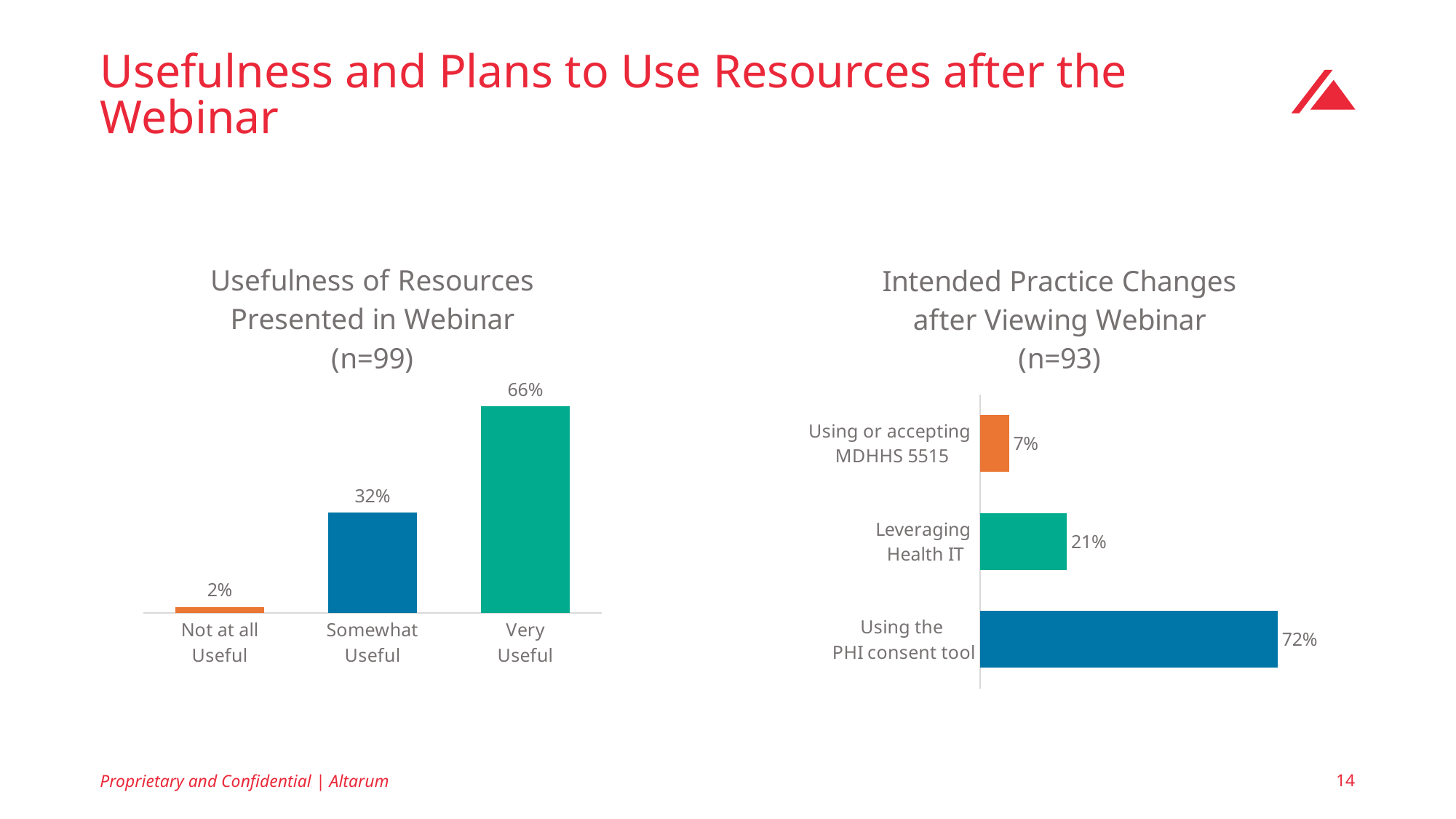
In the 'Intended Practice Changes after Viewing Webinar' chart, what is the difference between Using the PHI consent tool and Leveraging Health IT? 51% In the 'Usefulness of Resources Presented in Webinar' chart, what is the difference between Very Useful and Somewhat Useful? 34% In the 'Intended Practice Changes after Viewing Webinar' chart, what is the value for Leveraging Health IT? 21% In the 'Usefulness of Resources Presented in Webinar' chart, what is the value for Not at all Useful? 2% In the 'Usefulness of Resources Presented in Webinar' chart, which category has the highest value? Very Useful What kind of chart is the 'Intended Practice Changes after Viewing Webinar' chart? bar chart In the 'Usefulness of Resources Presented in Webinar' chart, do the values rise or fall from left to right? rise In the 'Intended Practice Changes after Viewing Webinar' chart, which is larger: Leveraging Health IT or Using or accepting MDHHS 5515? Leveraging Health IT In the 'Usefulness of Resources Presented in Webinar' chart, what is the value for Very Useful? 66% In the 'Usefulness of Resources Presented in Webinar' chart, how many categories are shown? 3 In the 'Intended Practice Changes after Viewing Webinar' chart, what is the value for Using the PHI consent tool? 72% In the 'Intended Practice Changes after Viewing Webinar' chart, which category has the lowest value? Using or accepting MDHHS 5515